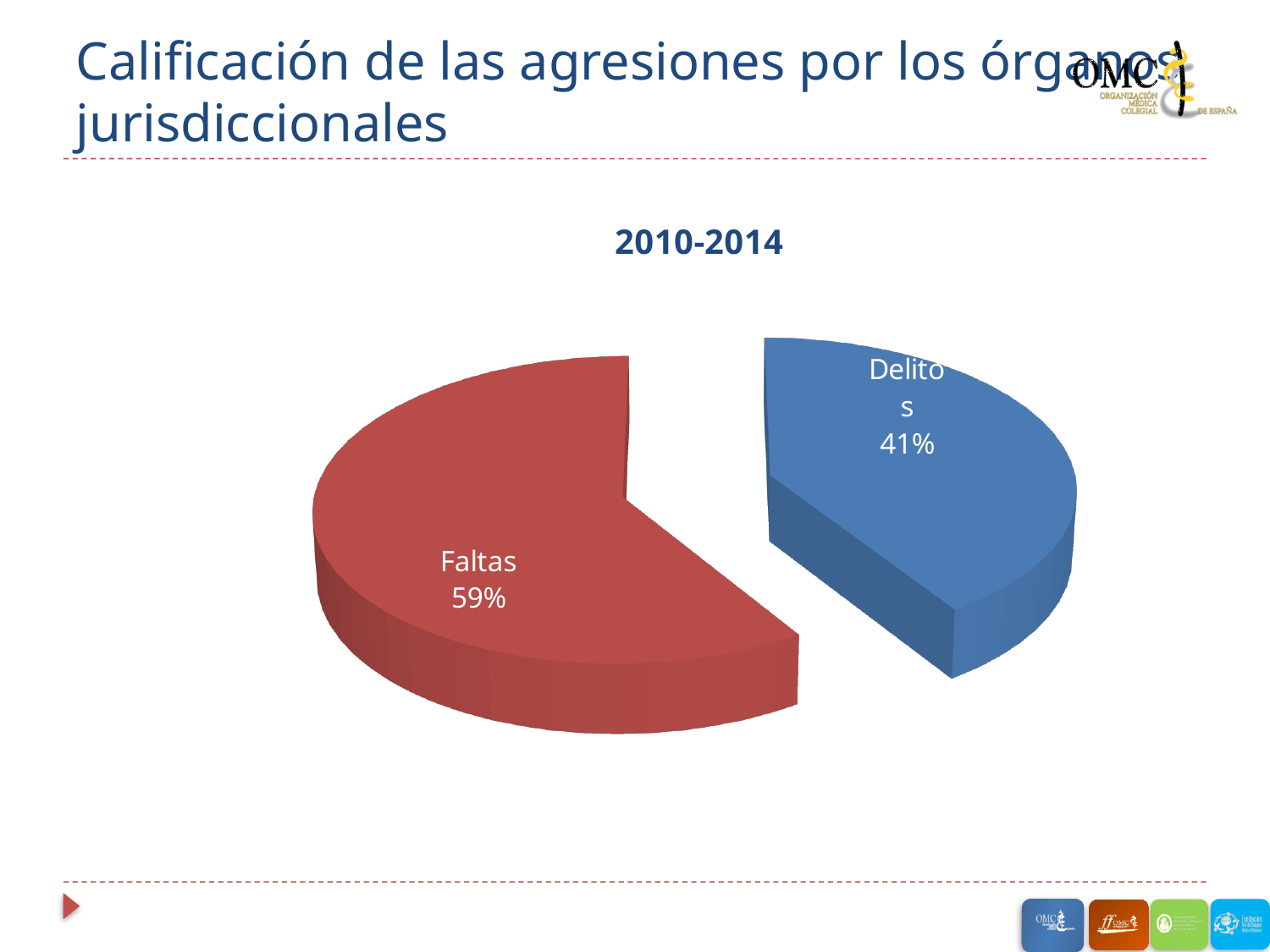
Which category has the largest slice of the pie? Faltas What share of the pie does Faltas represent? 59% What is the title of the chart? 2010-2014 What share of the pie does Delitos represent? 41% What is the difference in percentage points between Faltas and Delitos? 18 Which is larger, the share for Faltas or the share for Delitos? Faltas What kind of chart is shown on the slide? Pie chart Is the share for Delitos greater or less than 50%? less Which category has the smallest slice of the pie? Delitos What colour is the Delitos slice? Blue How many categories are shown in the pie chart? 2